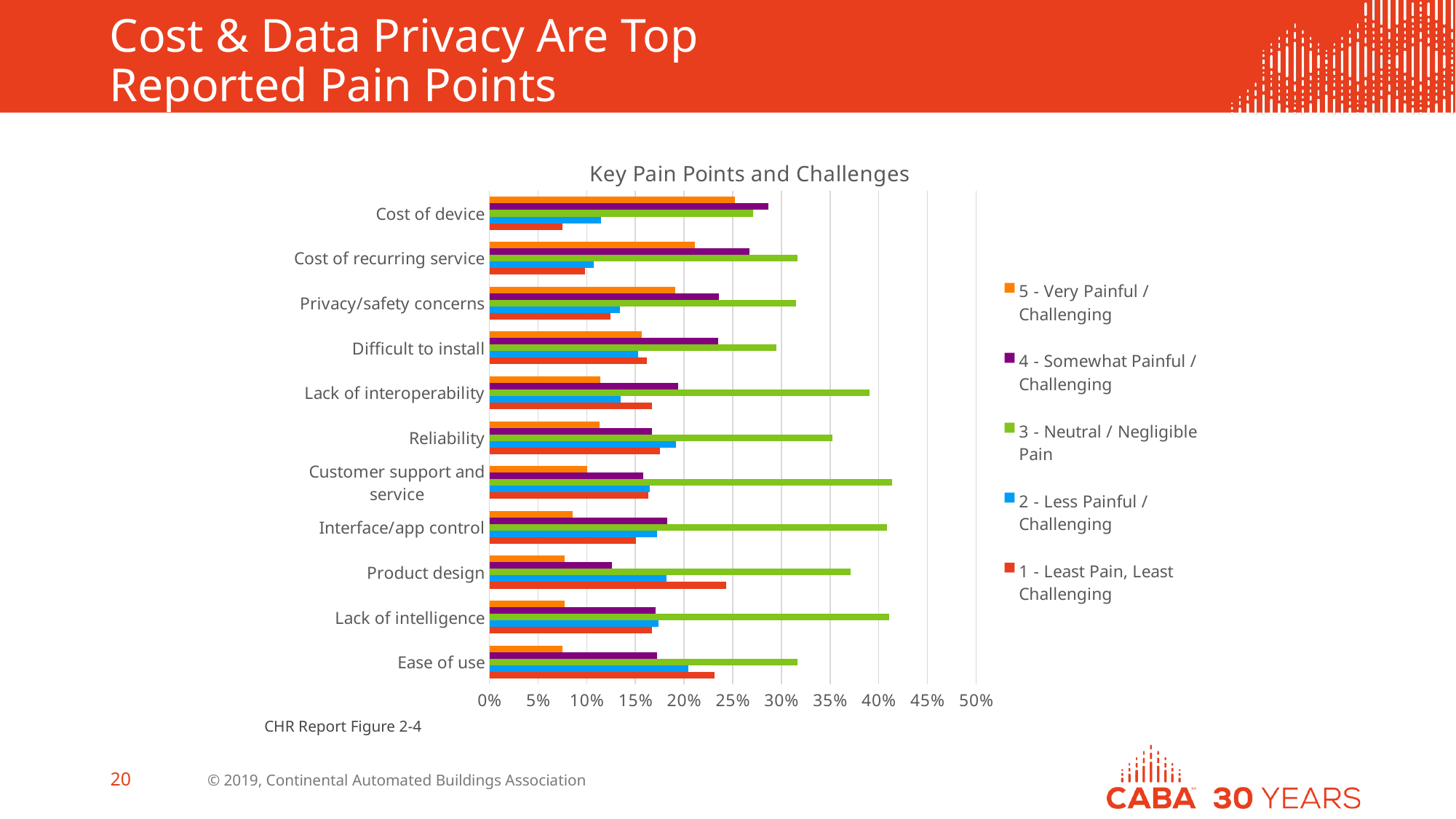
Is the '1 - Least Pain, Least Challenging' value for Cost of device greater or less than 10%? less What is the title of the chart? Key Pain Points and Challenges Going down the categories from Cost of device to Ease of use, does the '5 - Very Painful / Challenging' series generally rise or fall? fall Which category has the larger '5 - Very Painful / Challenging' value: Cost of device or Ease of use? Cost of device Is the '5 - Very Painful / Challenging' value for Ease of use greater or less than 10%? less Is the '3 - Neutral / Negligible Pain' value for Lack of interoperability greater or less than 35%? greater How many pain point categories are plotted on the chart? 11 What kind of chart is shown on the slide? bar chart Which is larger for Cost of device: the '4 - Somewhat Painful / Challenging' value or the '2 - Less Painful / Challenging' value? 4 - Somewhat Painful / Challenging Which category has the highest value for the '5 - Very Painful / Challenging' series? Cost of device How many series does the legend list? 5